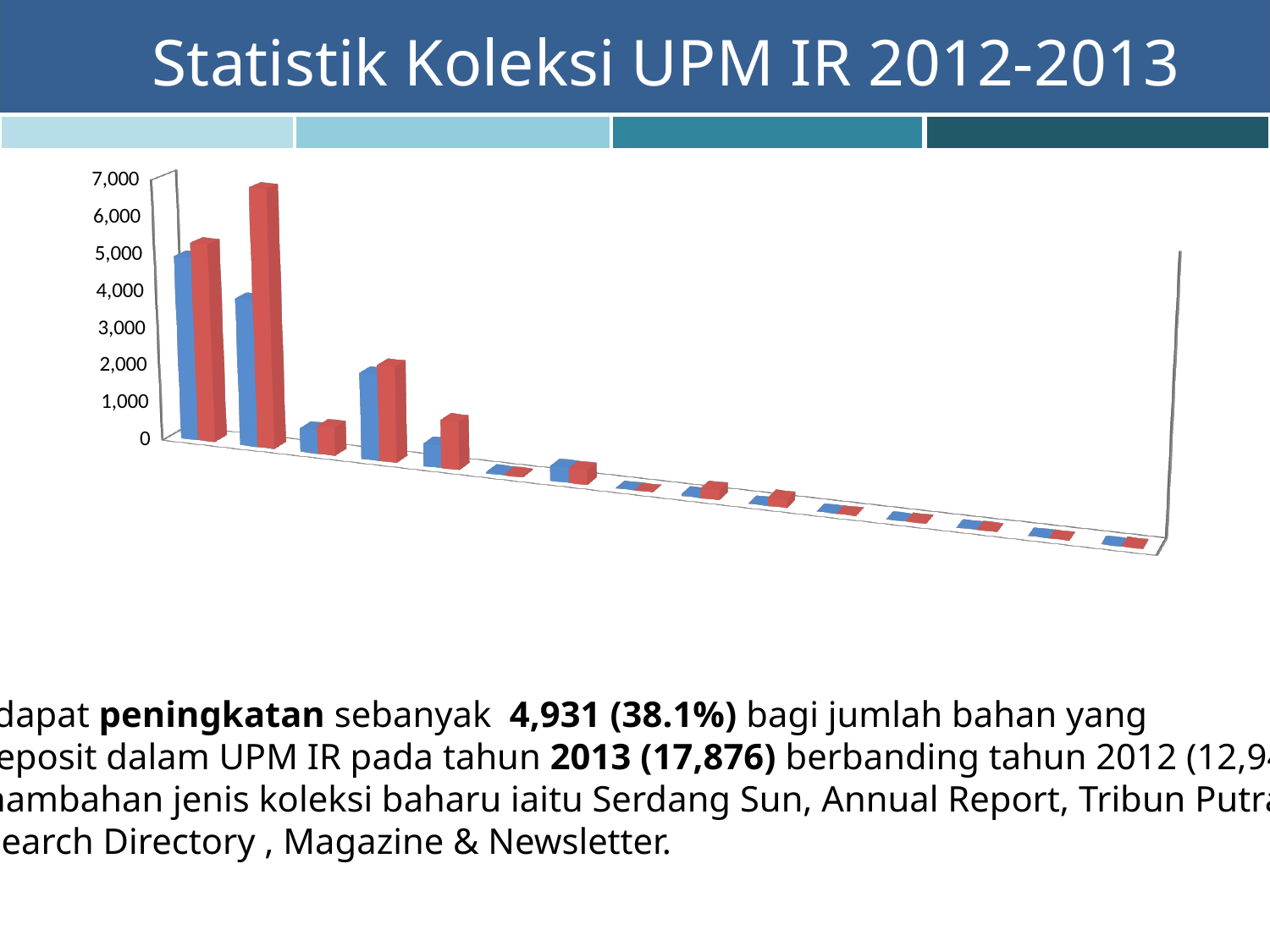
Is the red bar in the second group of bars from the left greater or less than 6,000? greater What kind of chart is shown on the slide? bar chart Is the blue bar in the first group of bars from the left greater or less than 4,000? greater In the second group of bars from the left, which bar is taller, the blue one or the red one? the red one Is the red bar in the third group of bars from the left greater or less than 1,000? less Which group of bars contains the tallest bar on the chart? the second group from the left What is the title of the slide containing the chart? Statistik Koleksi UPM IR 2012-2013 What is the highest value shown on the chart's vertical axis? 7,000 Do the bar heights generally rise or fall moving from left to right across the chart? fall